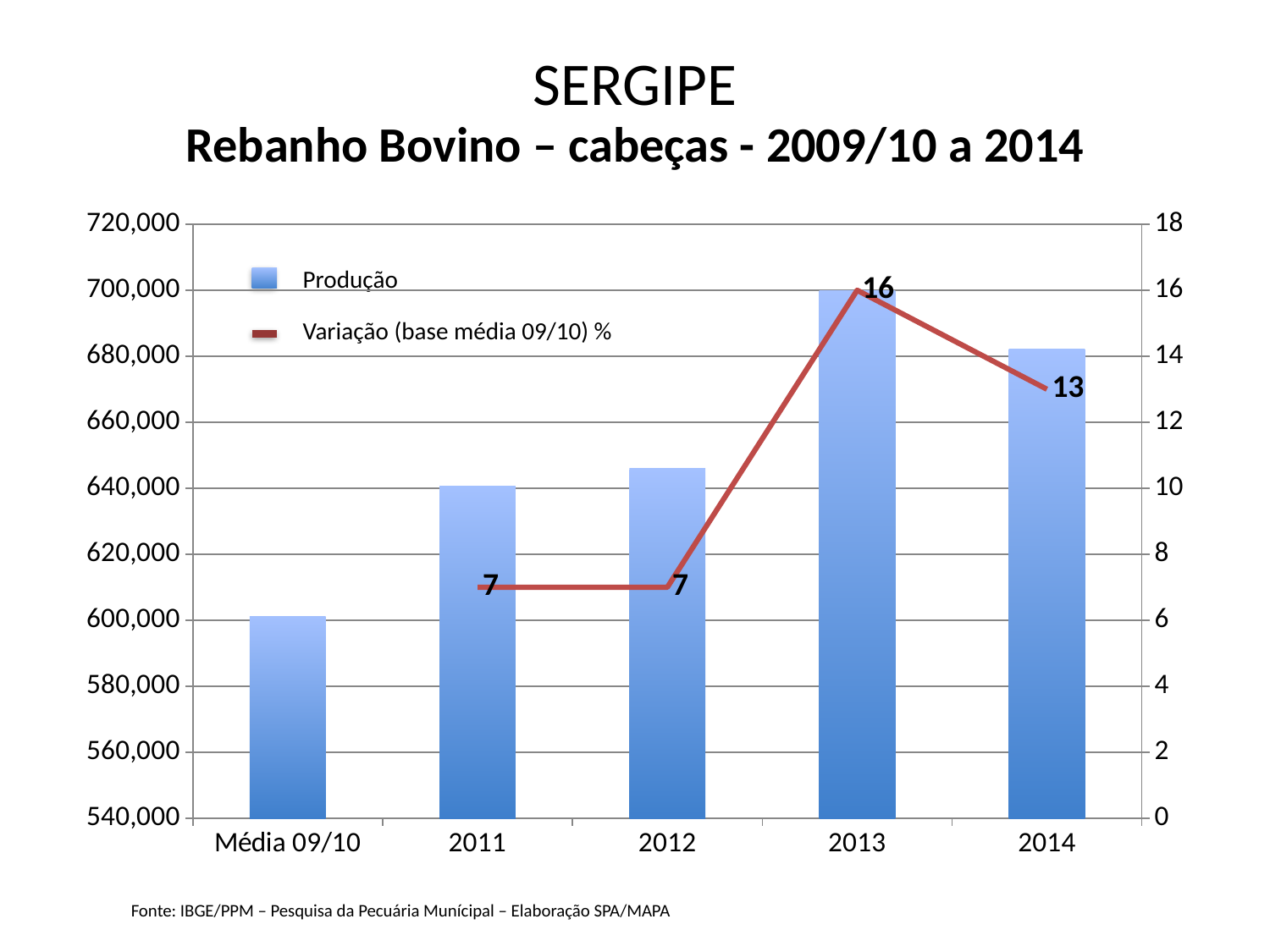
How many categories are shown on the x axis? 5 What is the Variação (base média 09/10) % value for 2013? 16 Which category has the lowest Produção bar? Média 09/10 Is the Produção value for 2014 greater or less than 660,000? greater How many series does the legend list? 2 What is the Variação (base média 09/10) % value for 2011? 7 Which category has the highest Produção bar? 2013 Is the Produção value for Média 09/10 greater or less than 620,000? less What is the Variação (base média 09/10) % value for 2014? 13 Which has a larger Produção value, 2013 or 2014? 2013 Does the Variação % line rise or fall from 2013 to 2014? fall What is the difference between the Variação % values for 2013 and 2014? 3